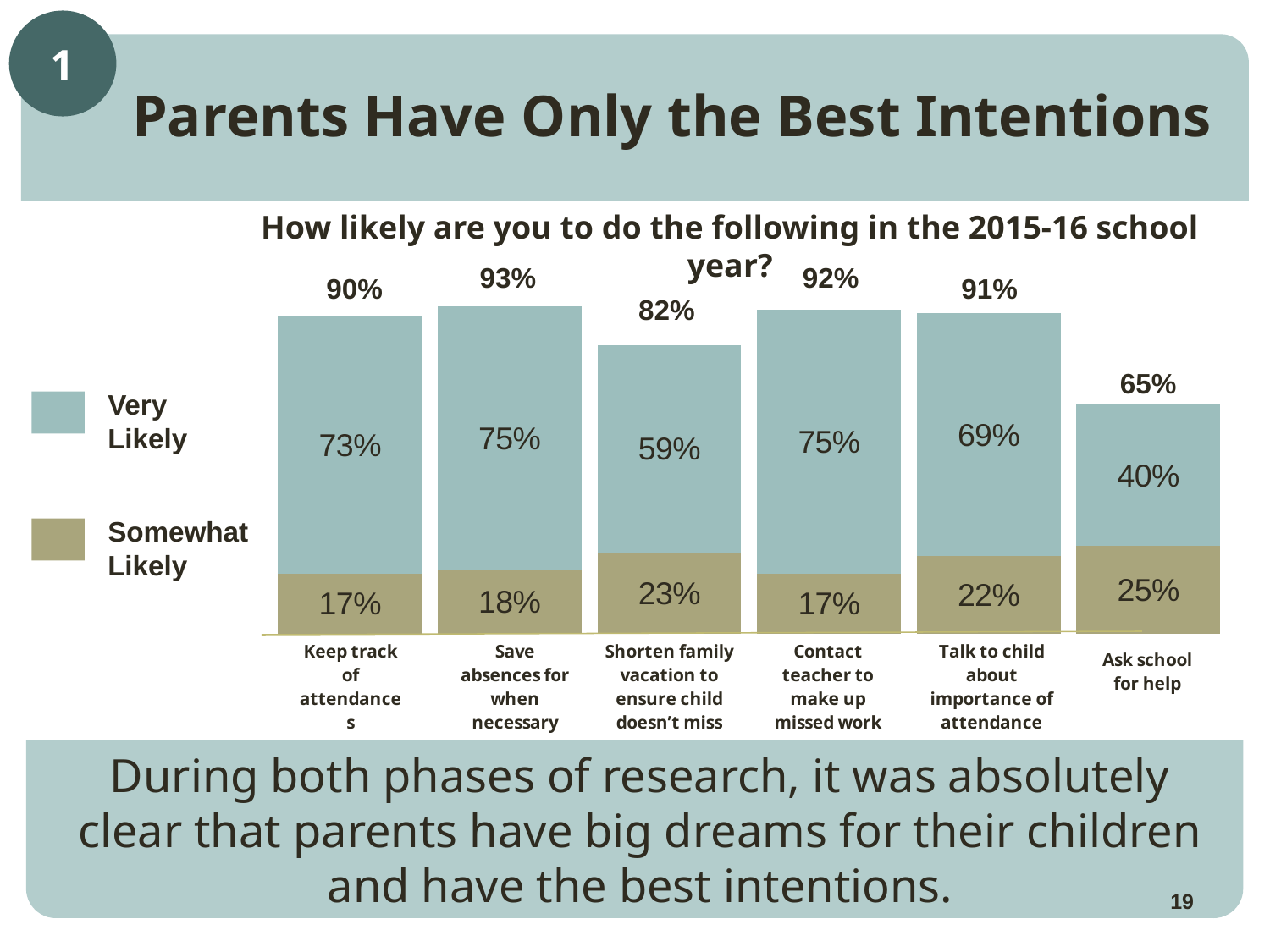
How many series does the legend list? 2 What is the 'Very Likely' value for 'Shorten family vacation to ensure child doesn't miss'? 59% What is the 'Somewhat Likely' value for 'Talk to child about importance of attendance'? 22% What is the title of the chart? How likely are you to do the following in the 2015-16 school year? What is the difference between the 'Very Likely' values for 'Contact teacher to make up missed work' and 'Talk to child about importance of attendance'? 6% Which category has the lowest 'Very Likely' value? Ask school for help What is the total shown above the bar for 'Save absences for when necessary'? 93% Which is larger: the 'Somewhat Likely' value for 'Shorten family vacation to ensure child doesn't miss' or for 'Keep track of attendances'? Shorten family vacation to ensure child doesn't miss What kind of chart is shown on the slide? Stacked bar chart Which category has the highest total percentage? Save absences for when necessary How many categories are shown on the x axis? 6 What is the 'Somewhat Likely' value for 'Ask school for help'? 25%